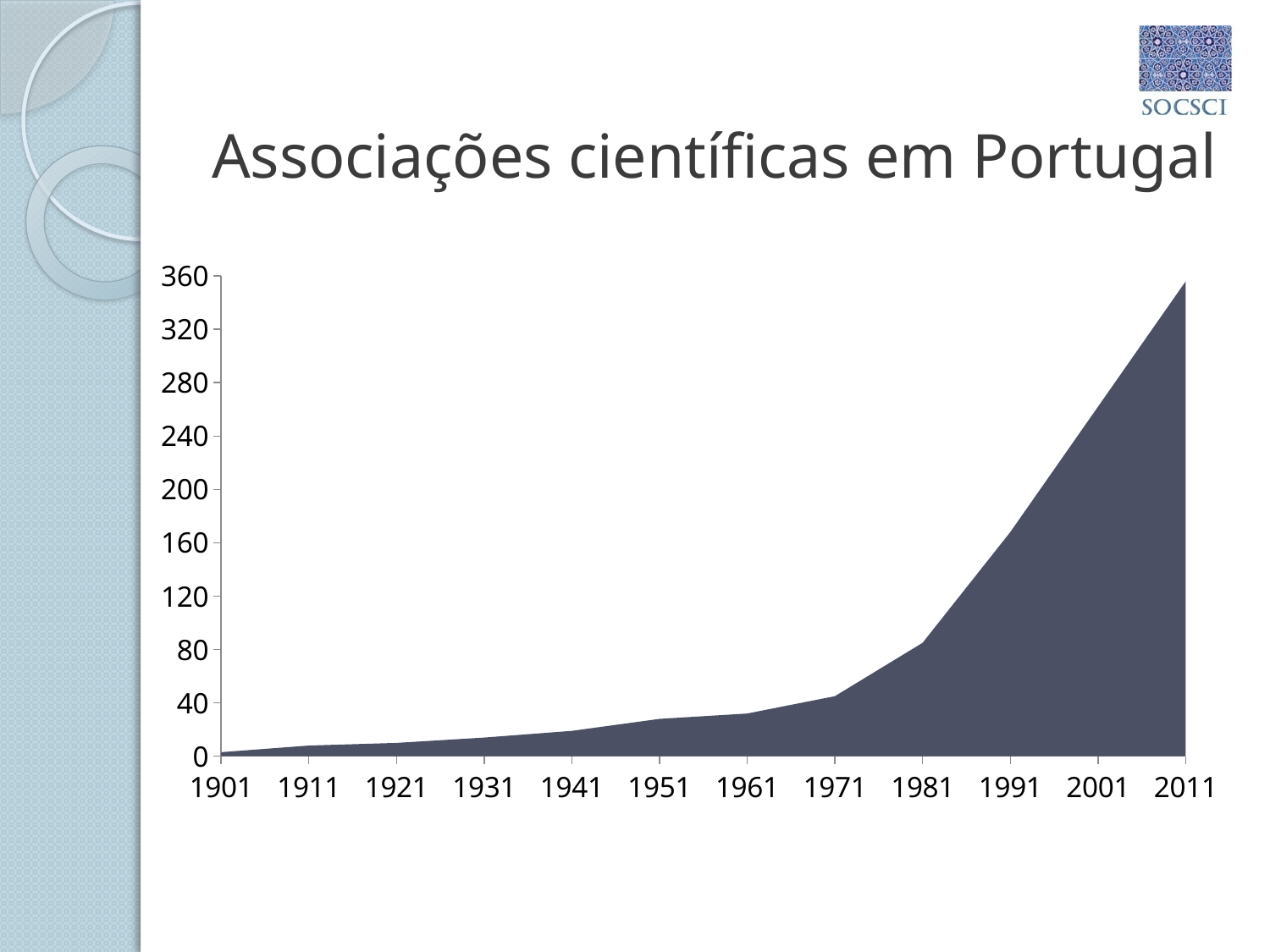
Which is larger, the value for 1971 or the value for 1991? 1991 What kind of chart is shown on the slide? area chart Which year has the lowest value in the chart? 1901 Is the value for 2001 greater or less than 200? greater Do the values rise or fall from 1901 to 2011? rise Is the value for 2011 greater or less than 320? greater Is the value for 1991 greater or less than 120? greater How many years are labelled on the x axis of the chart? 12 Which year has the highest value in the chart? 2011 What is the title of the slide containing the chart? Associações científicas em Portugal